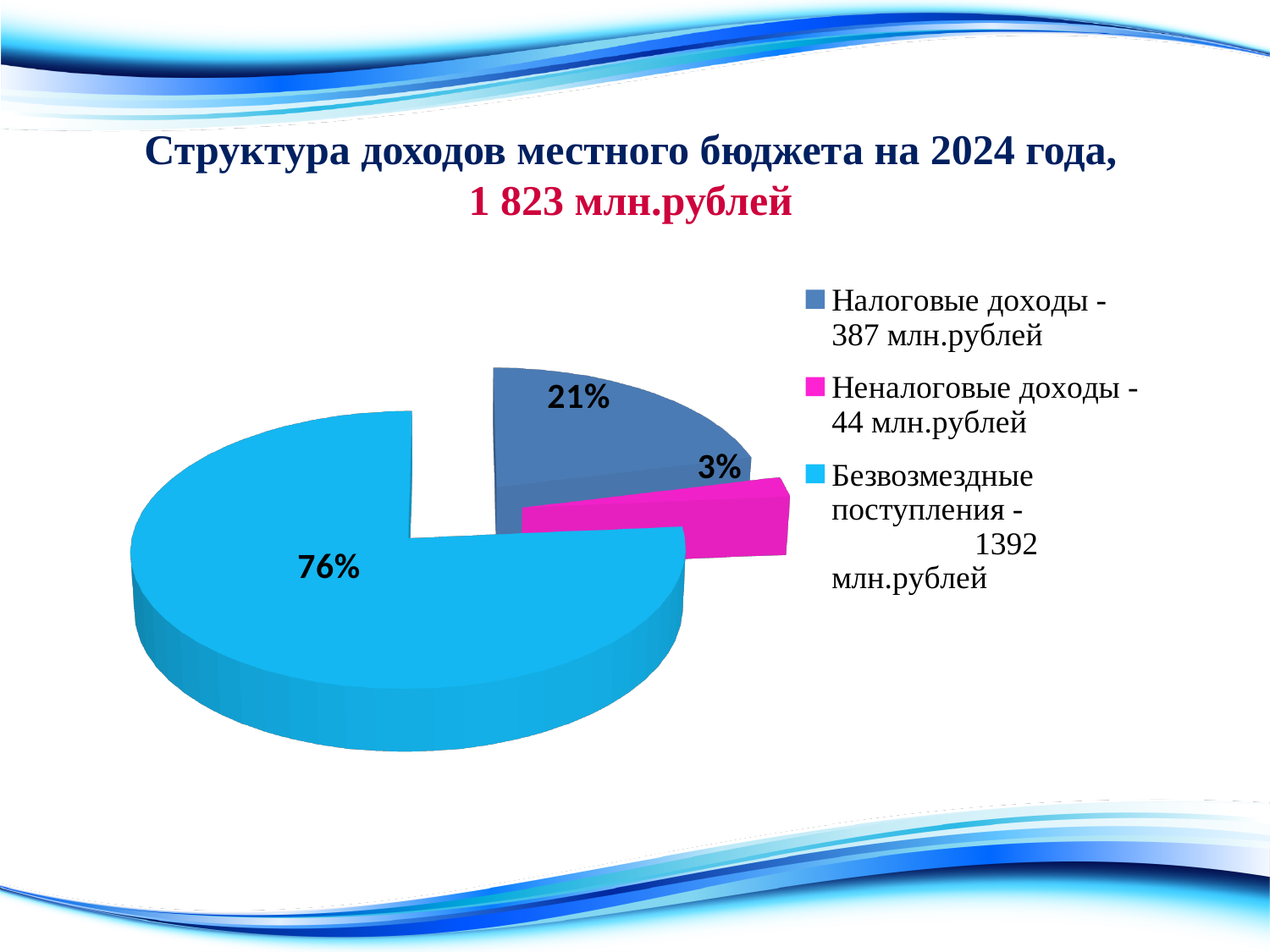
What is the difference in percentage points between the Безвозмездные поступления slice and the Налоговые доходы slice? 55 percentage points Which category has the largest slice of the pie? Безвозмездные поступления According to the legend, what amount in млн.рублей corresponds to Налоговые доходы? 387 млн.рублей Which category has the smallest slice of the pie? Неналоговые доходы How many slices does the pie chart have? 3 What colour is the slice for Неналоговые доходы? Pink (magenta) What share of the pie does Налоговые доходы take? 21% Which is larger, the share for Налоговые доходы or the share for Неналоговые доходы? Налоговые доходы What share of the pie does Безвозмездные поступления take? 76% What share of the pie does Неналоговые доходы take? 3% How many entries does the legend list? 3 What kind of chart is shown on the slide? Pie chart